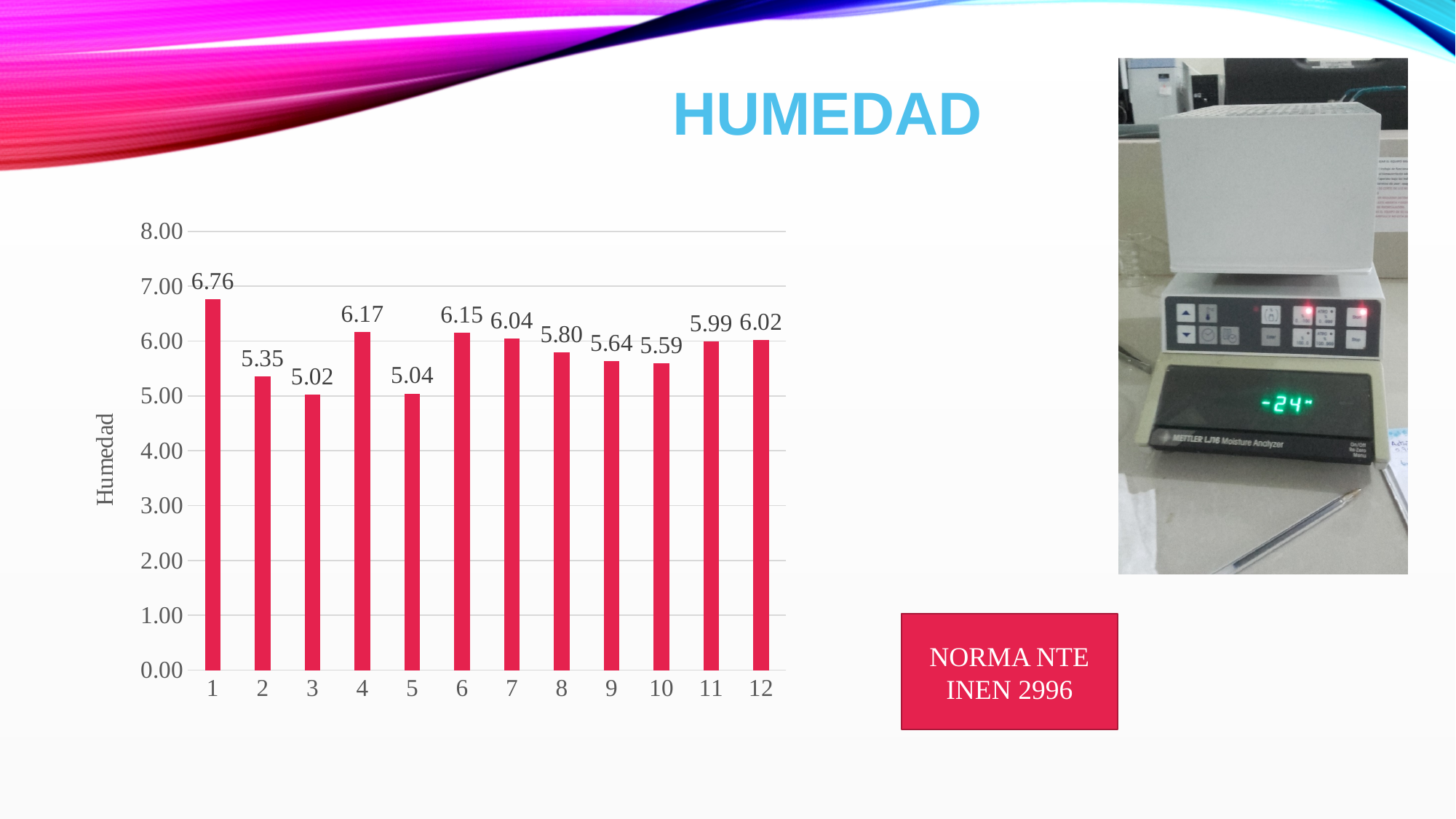
What is the difference between the Humedad values for categories 4 and 5? 1.13 What is the Humedad value for category 1? 6.76 What is the Humedad value for category 12? 6.02 What is the label of the vertical axis of the chart? Humedad What kind of chart is shown on the slide? bar chart What is the Humedad value for category 7? 6.04 Which category has the lowest Humedad value? 3 Which category has the highest Humedad value? 1 What is the difference between the Humedad values for categories 1 and 3? 1.74 Is the Humedad value for category 9 greater or less than 5.00? greater Which has a larger Humedad value, category 2 or category 8? 8 How many categories are shown on the x axis of the chart? 12